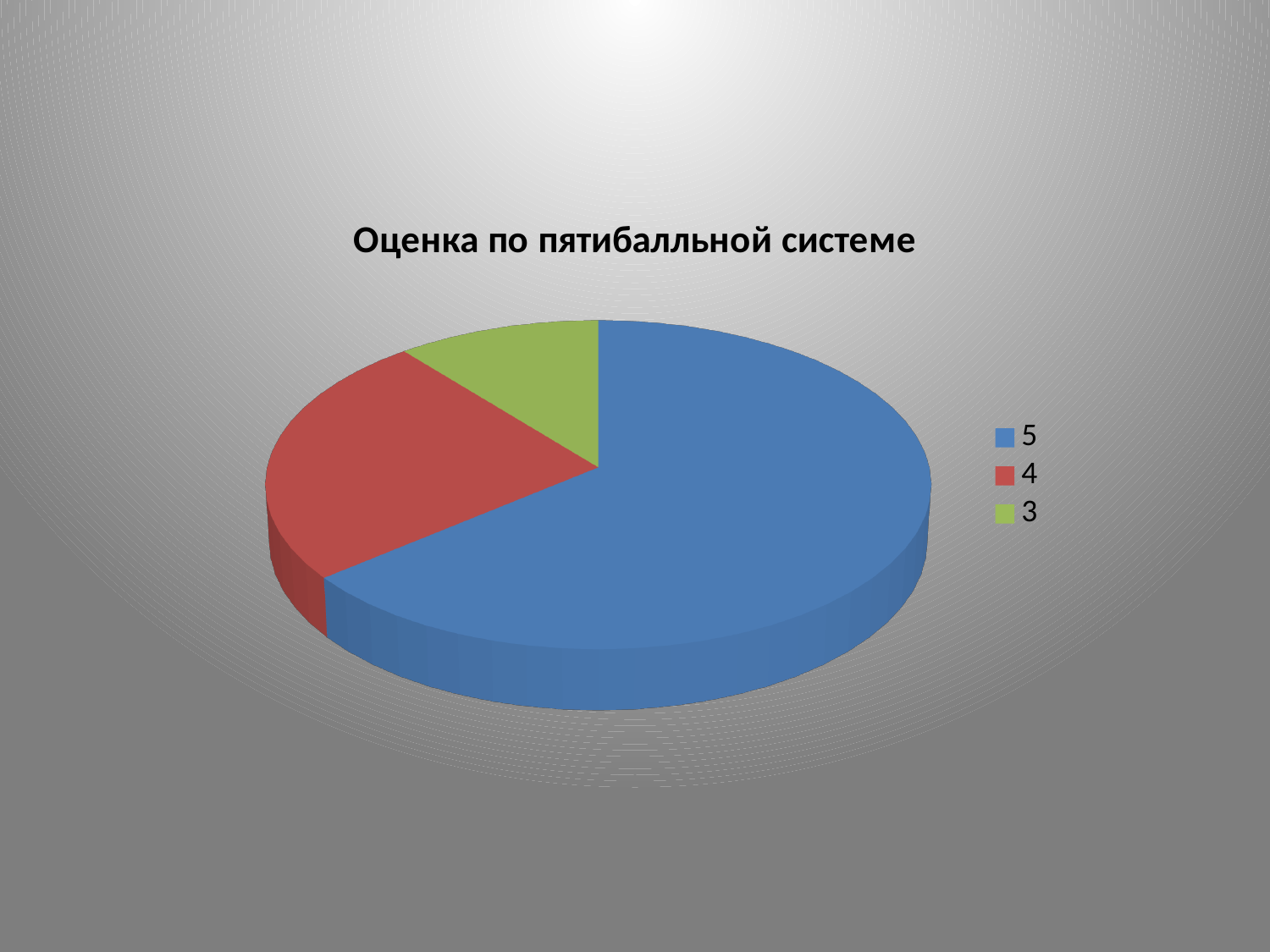
Which slice is larger, the one for 4 or the one for 3? 4 Which category has the smallest slice of the pie? 3 Which category has the largest slice of the pie? 5 What is the title of the chart? Оценка по пятибалльной системе What kind of chart is shown on the slide? pie chart Which slice is larger, the one for 5 or the one for 4? 5 How many slices does the pie chart have? 3 What colour is the slice for category 5? blue Does the slice for category 5 take up more or less than half of the pie? more How many entries does the legend list? 3